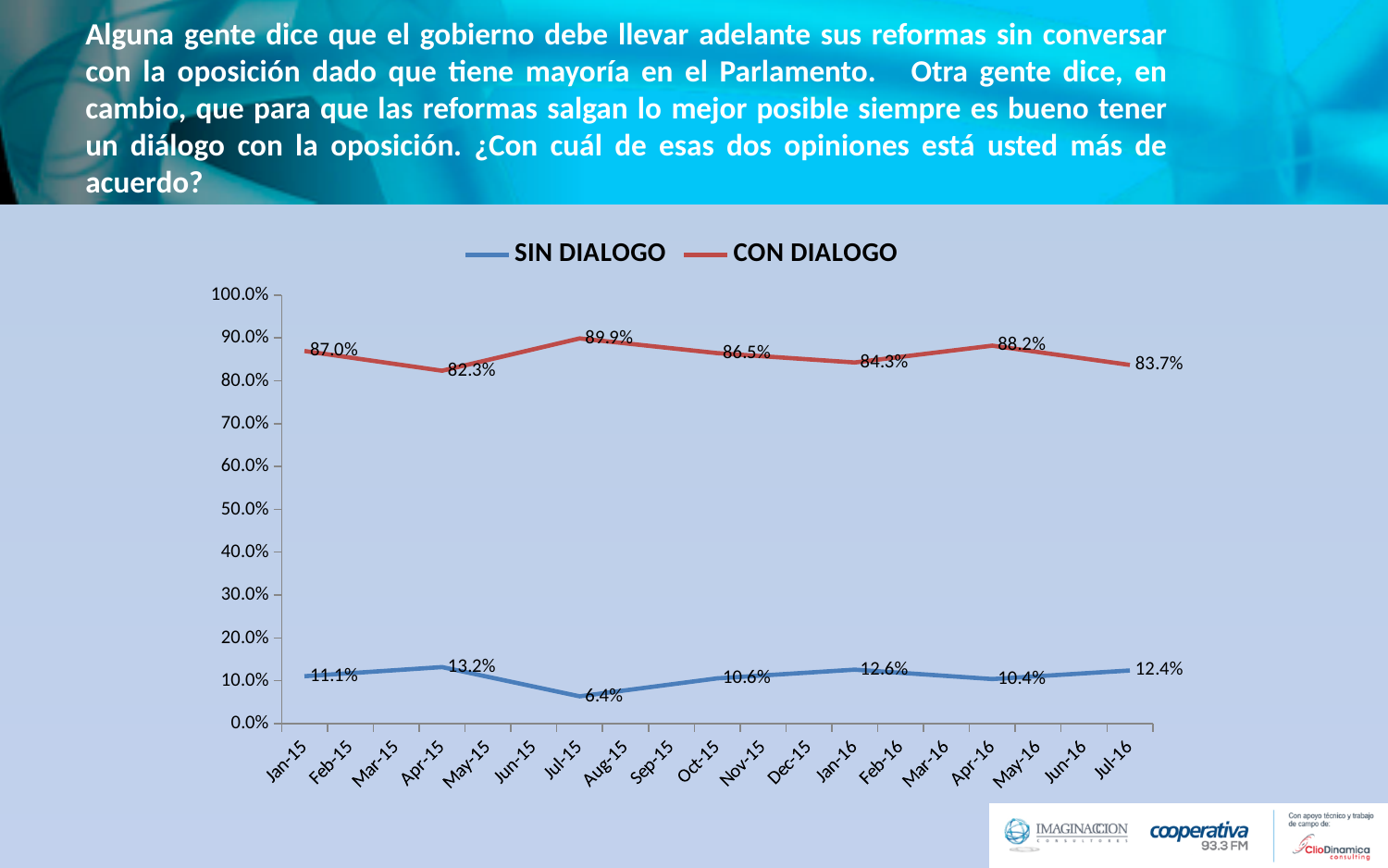
How many series does the legend list? 2 Is the value for CON DIALOGO in Apr-15 greater or less than 90.0%? less In which month does the SIN DIALOGO series reach its lowest value? Jul-15 What is the value for CON DIALOGO in Jan-15? 87.0% What type of chart is shown on the slide? line chart Which is larger, the SIN DIALOGO value in Apr-15 or in Jan-16? Apr-15 How many labelled data points does the CON DIALOGO line have? 7 In which month does the CON DIALOGO series reach its highest value? Jul-15 What is the value for SIN DIALOGO in Apr-16? 10.4% Which colour is used for the SIN DIALOGO line? blue What is the difference between the CON DIALOGO values in Jul-15 and Apr-15? 7.6% What is the value for CON DIALOGO in Jul-15? 89.9%